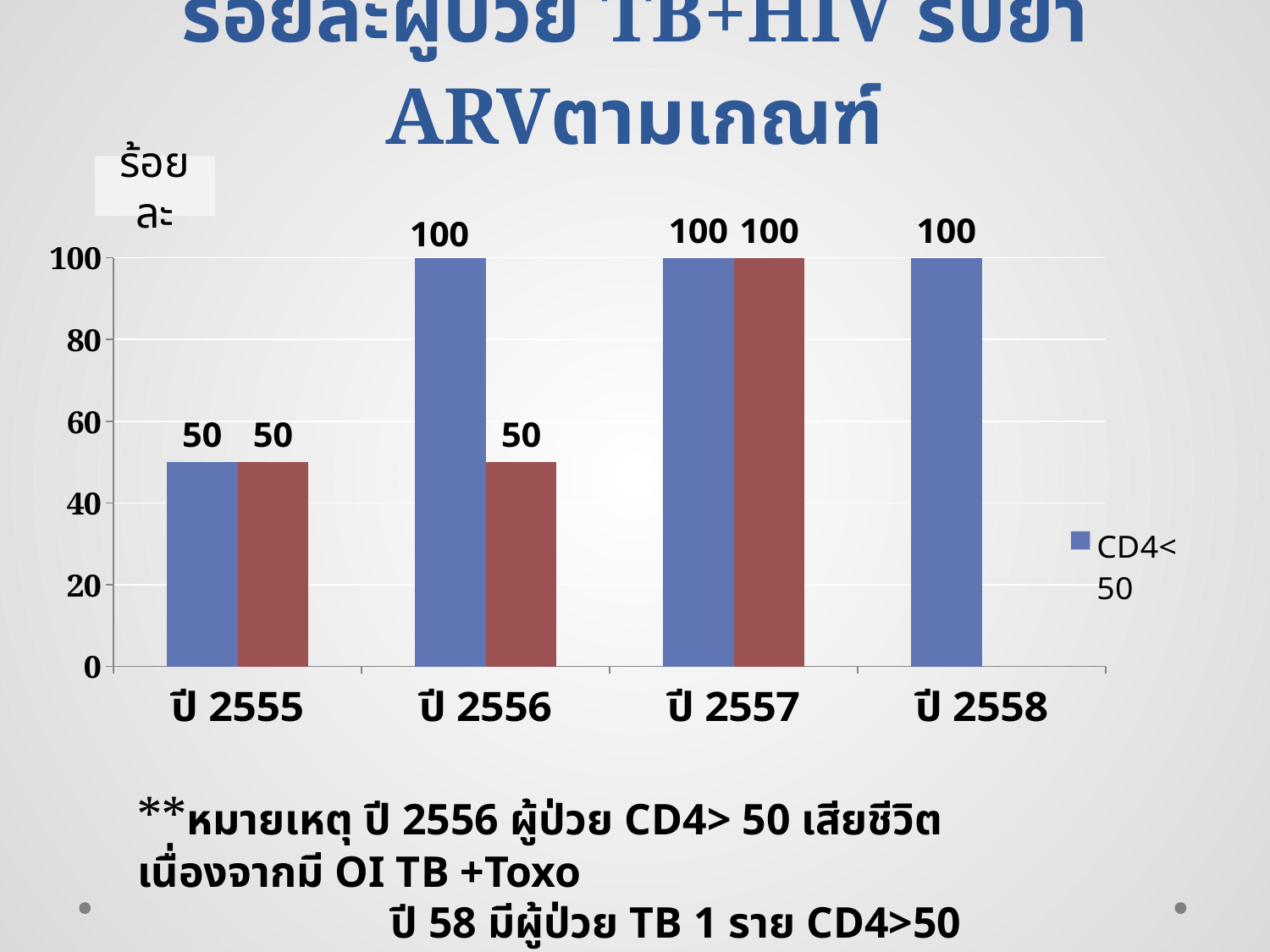
What is the value of the CD4< 50 series for ปี 2556? 100 Does the CD4< 50 series rise or fall from ปี 2555 to ปี 2556? rise What is the value of the CD4< 50 series for ปี 2558? 100 For ปี 2556, which is larger: the blue CD4< 50 bar or the red bar? the blue CD4< 50 bar What is the value of the red bar for ปี 2556? 50 In which year is the CD4< 50 value lowest? ปี 2555 What is the difference between the blue (CD4< 50) bar and the red bar for ปี 2556? 50 What series name is shown in the chart legend? CD4< 50 What is the value of the red bar for ปี 2557? 100 What is the value of the CD4< 50 series for ปี 2555? 50 What kind of chart is shown on the slide? bar chart How many year categories are shown on the x axis? 4